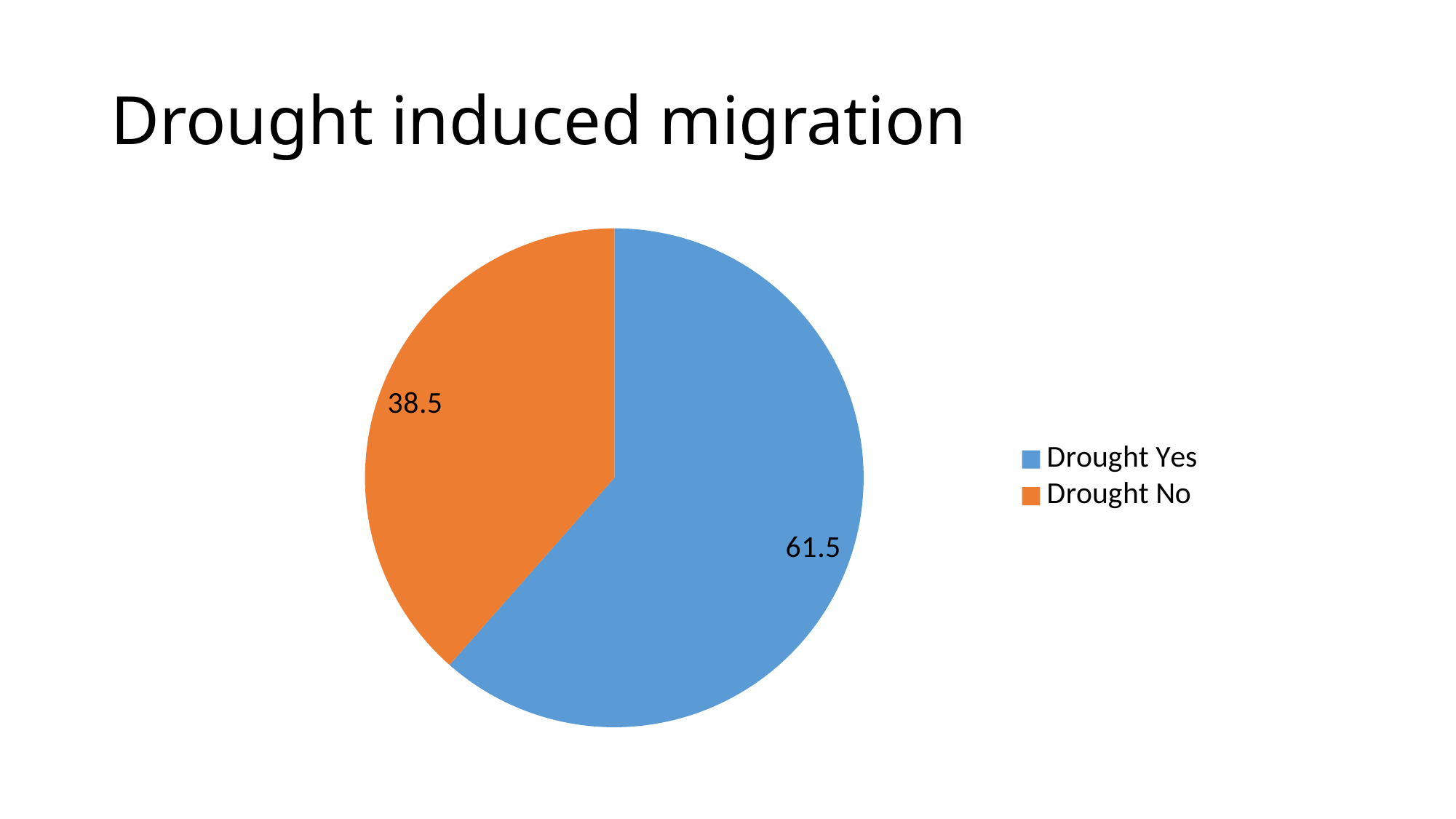
What is the difference between the values for Drought Yes and Drought No? 23 How many slices does the pie chart have? 2 Which category has the largest slice? Drought Yes What kind of chart is shown on the slide? pie chart Which is larger, Drought Yes or Drought No? Drought Yes What share of the pie does Drought Yes represent? 61.5 What colour is the Drought No slice? orange What is the value for Drought Yes? 61.5 How many entries does the legend list? 2 What is the title of the slide? Drought induced migration What is the value for Drought No? 38.5 Which category has the smallest slice? Drought No